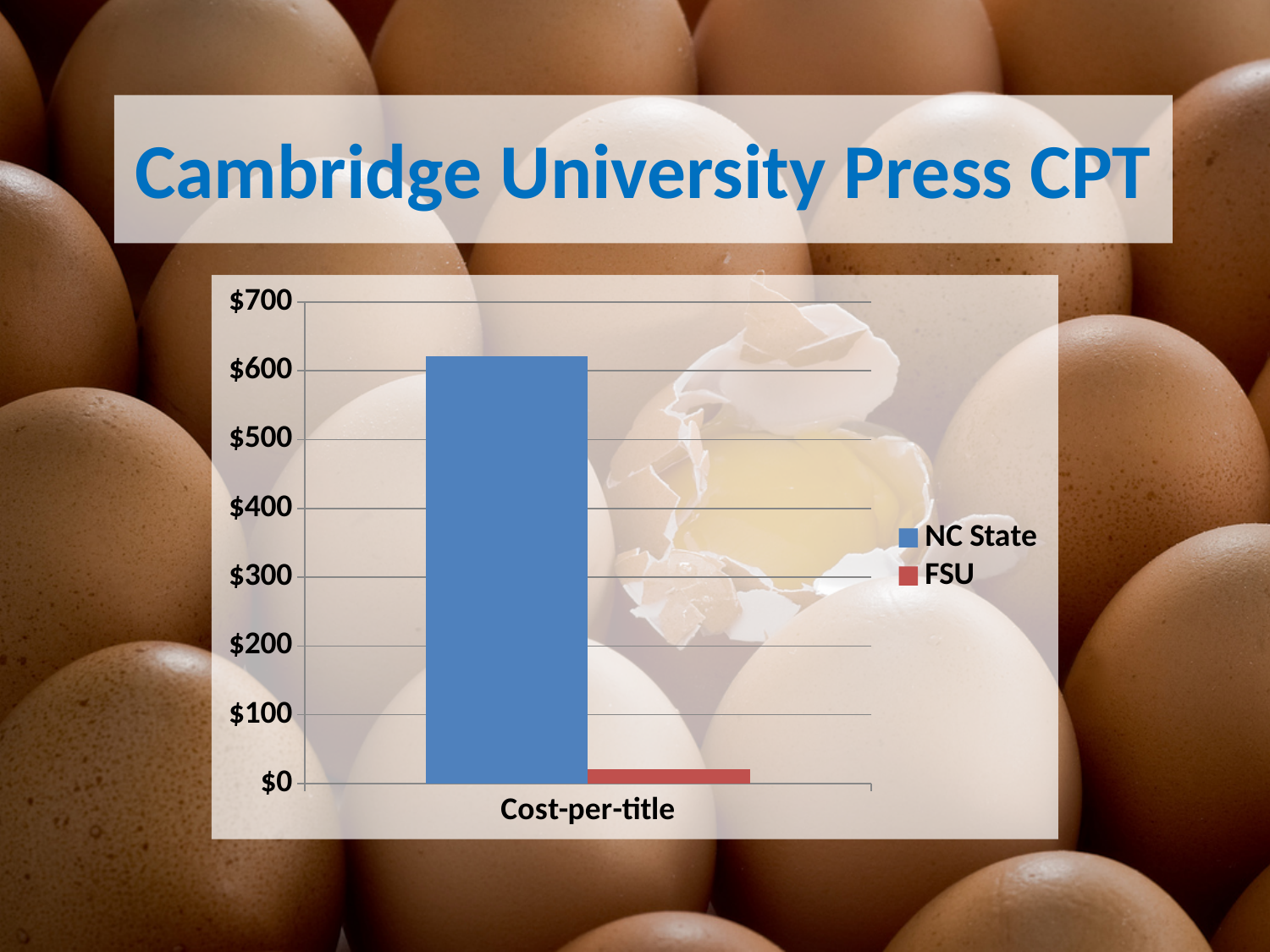
Which series has the higher cost-per-title, NC State or FSU? NC State Which series has the lowest cost-per-title? FSU How many categories are shown on the x axis? 1 Is the cost-per-title for NC State greater or less than $700? less What colour is the bar for FSU? red What is the label of the category on the x axis? Cost-per-title How many series does the legend list? 2 Is the cost-per-title for NC State greater or less than $500? greater What kind of chart is shown on the slide? bar chart Is the cost-per-title for FSU greater or less than $100? less